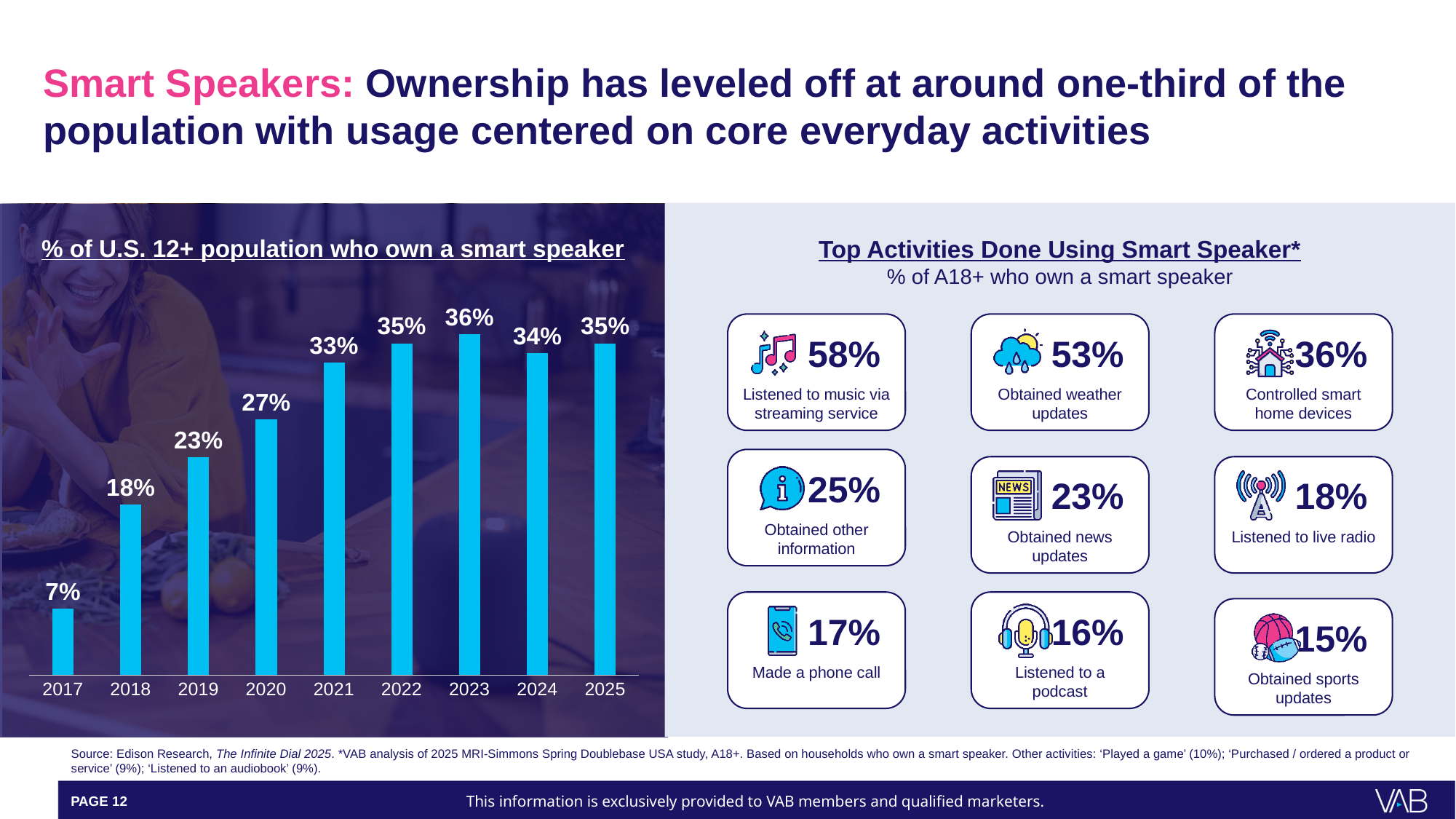
In the chart '% of U.S. 12+ population who own a smart speaker', which year has the lowest value? 2017 In the chart '% of U.S. 12+ population who own a smart speaker', what is the difference between the 2025 value and the 2017 value? 28 percentage points In the 'Top Activities Done Using Smart Speaker' panel, what percentage listened to music via streaming service? 58% In the chart '% of U.S. 12+ population who own a smart speaker', what is the value for 2021? 33% In the chart '% of U.S. 12+ population who own a smart speaker', do the values generally rise or fall from 2017 to 2023? Rise In the chart '% of U.S. 12+ population who own a smart speaker', what is the value for 2017? 7% In the chart '% of U.S. 12+ population who own a smart speaker', which is larger, the value for 2019 or the value for 2020? 2020 In the chart '% of U.S. 12+ population who own a smart speaker', what is the value for 2025? 35% In the chart '% of U.S. 12+ population who own a smart speaker', which year has the highest value? 2023 In the chart '% of U.S. 12+ population who own a smart speaker', what is the difference between the 2023 value and the 2024 value? 2 percentage points How many years are shown in the chart '% of U.S. 12+ population who own a smart speaker'? 9 What kind of chart is '% of U.S. 12+ population who own a smart speaker'? Bar chart